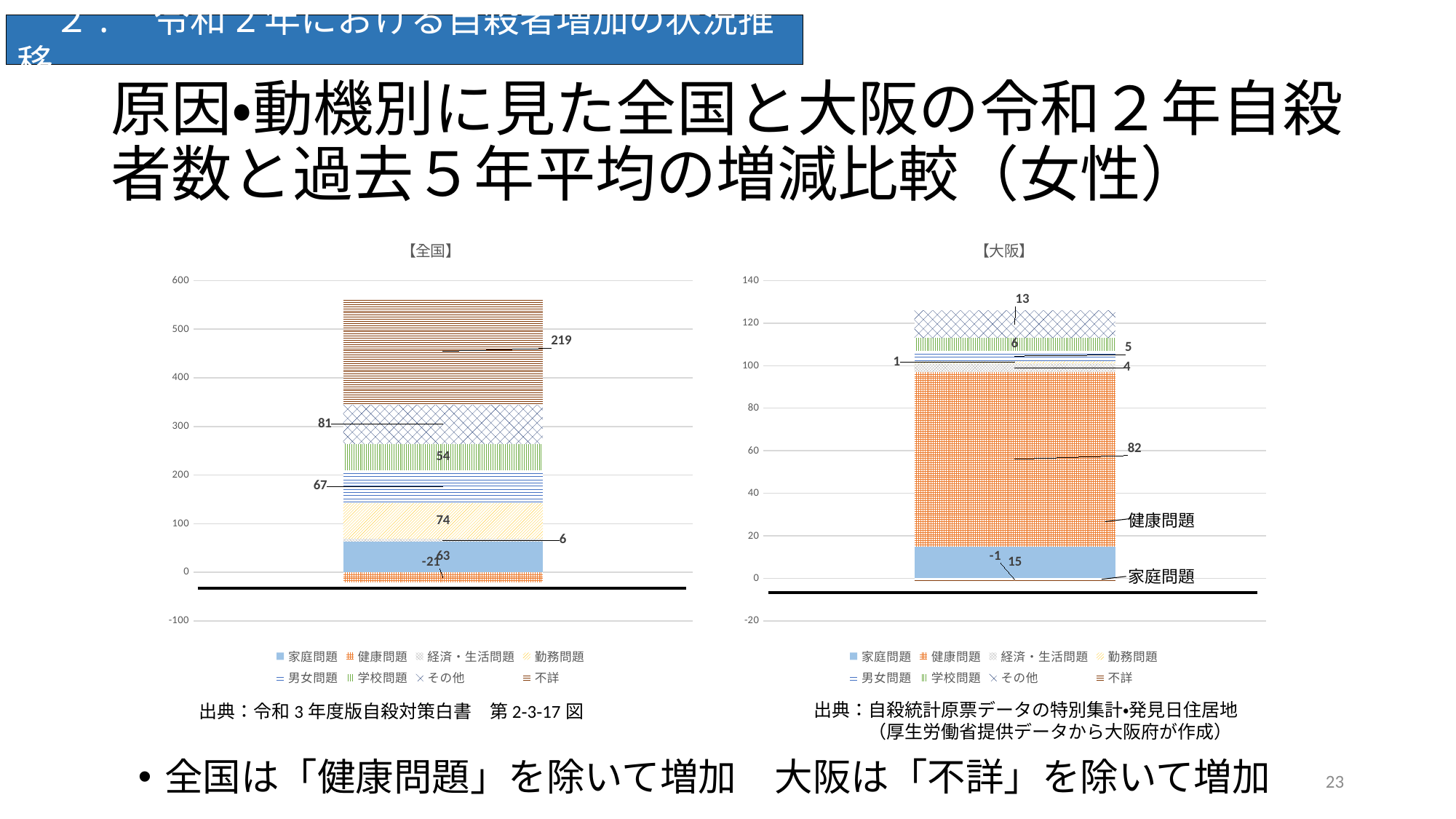
In the 【全国】 chart, what is the value for 健康問題? -21 In the 【全国】 chart, what is the value for 勤務問題? 74 What kind of chart is the 【全国】 chart? Stacked bar chart In the 【大阪】 chart, what is the value for 家庭問題? 15 In the 【大阪】 chart, which is larger, the value for その他 or the value for 学校問題? その他 In the 【全国】 chart, what is the value for 不詳? 219 In the 【大阪】 chart, which category has the highest value? 健康問題 How many series does the legend of the 【大阪】 chart list? 8 In the 【全国】 chart, which category has the lowest value? 健康問題 In the 【全国】 chart, which category has the highest value? 不詳 In the 【大阪】 chart, what is the value for 健康問題? 82 In the 【全国】 chart, what is the difference between the values for その他 and 学校問題? 27